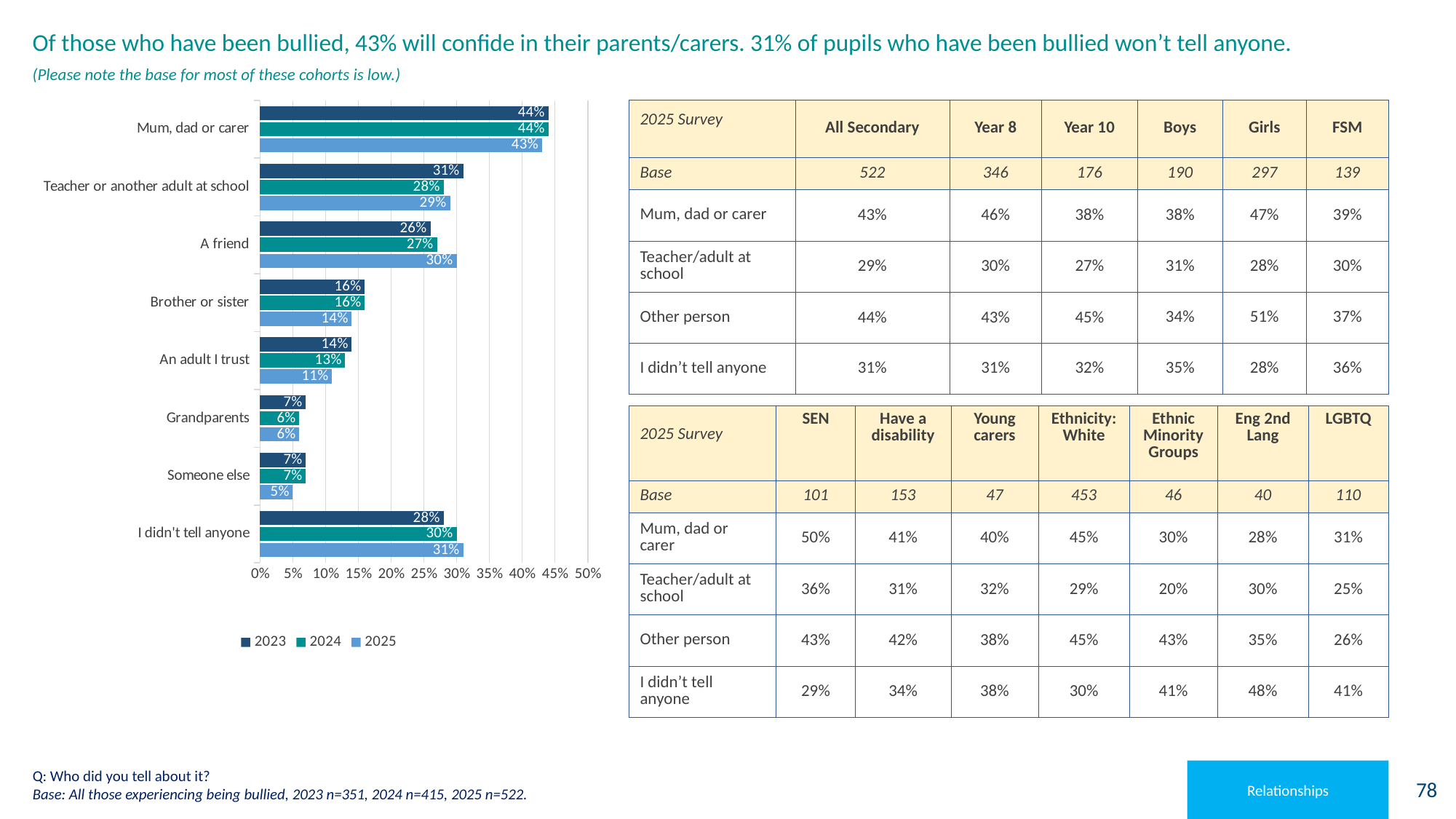
Which category has the lowest 2025 value? Someone else What kind of chart is shown on the slide? bar chart How many categories are shown on the bar chart? 8 Is the 2025 value for 'Mum, dad or carer' greater or less than 40%? greater What is the 2024 value for 'I didn't tell anyone'? 30% Which years are listed in the chart legend? 2023, 2024, 2025 How many series does the legend list? 3 What is the 2023 value for 'Teacher or another adult at school'? 31% What is the 2025 value for 'A friend'? 30% Which category has the highest 2025 value? Mum, dad or carer Which is larger for 'Brother or sister': the 2024 value or the 2025 value? 2024 What is the difference between the 2023 and 2025 values for 'An adult I trust'? 3%